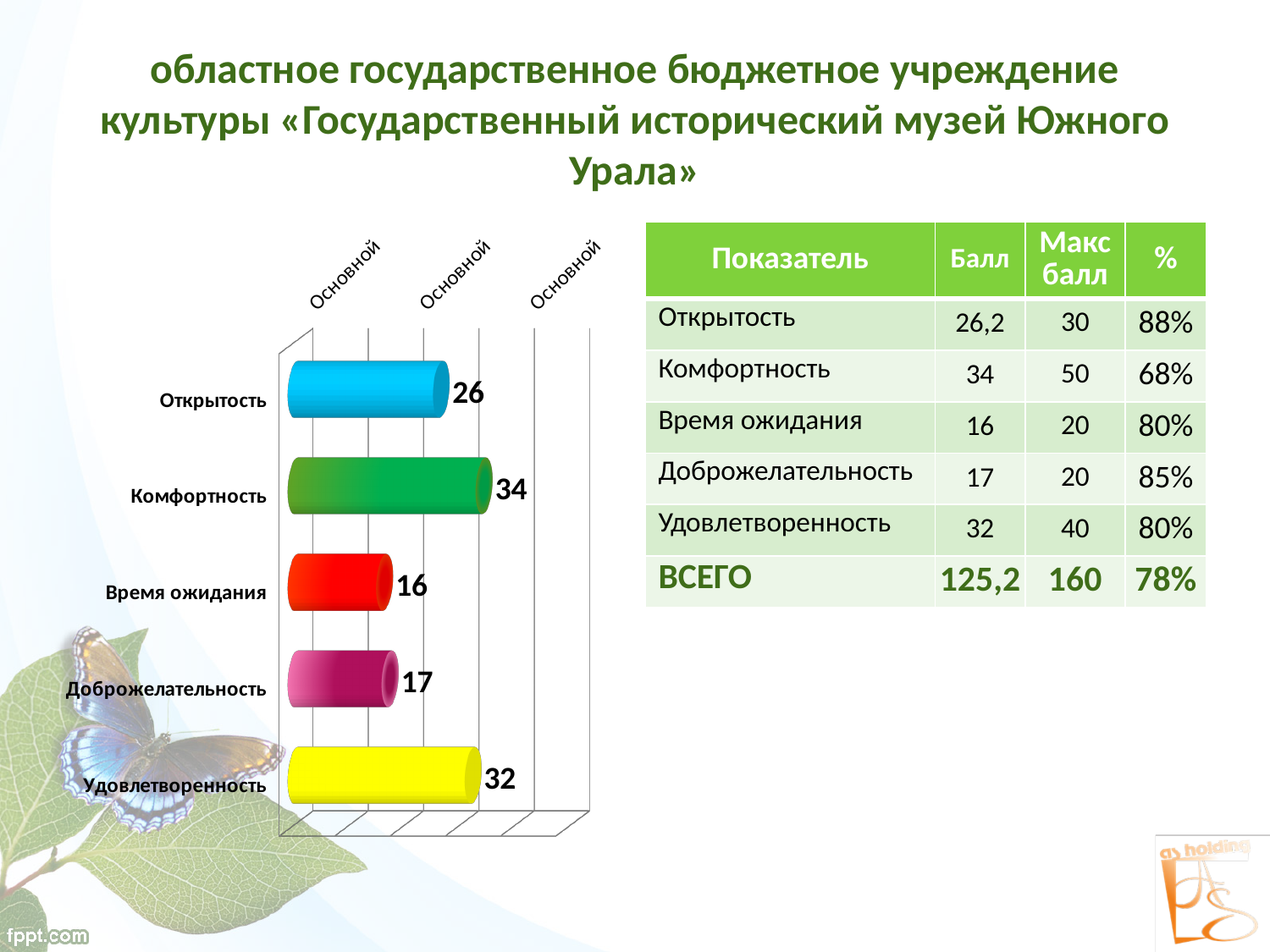
What value does the chart show for Время ожидания? 16 What colour is the bar for Удовлетворенность in the chart? Yellow What value does the chart show for Удовлетворенность? 32 What kind of chart is shown on the slide? Bar chart What value does the chart show for Открытость? 26 What value does the chart show for Комфортность? 34 What is the difference between the values for Комфортность and Открытость in the chart? 8 Which category has the lowest value in the chart? Время ожидания How many categories are plotted in the chart? 5 What is the difference between the values for Удовлетворенность and Доброжелательность in the chart? 15 Which category has the highest value in the chart? Комфортность Which is larger in the chart, the value for Доброжелательность or the value for Время ожидания? Доброжелательность